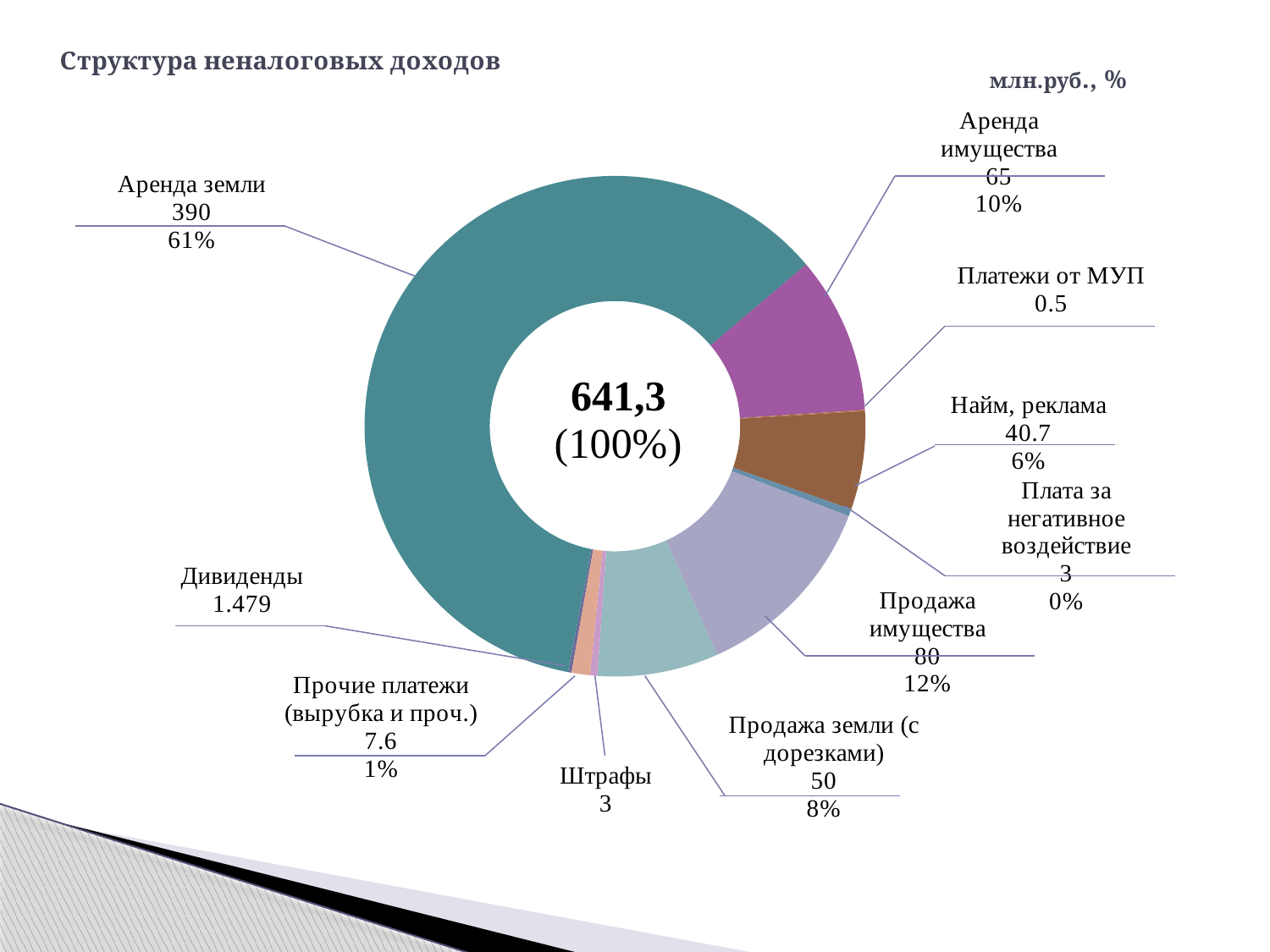
What is the value for Продажа имущества? 80 What is the value for Дивиденды? 1.479 Which category has the smallest value? Платежи от МУП What share of the total does Аренда земли represent? 61% Which is larger, Продажа имущества or Аренда имущества? Продажа имущества What is the value for Аренда земли? 390 What is the value for Найм, реклама? 40.7 What is the difference between the values for Аренда имущества and Продажа земли (с дорезками)? 15 Which category has the largest value? Аренда земли What kind of chart is shown on the slide? Pie (donut) chart What total value is shown in the centre of the chart? 641,3 (100%) How many categories does the chart show? 10